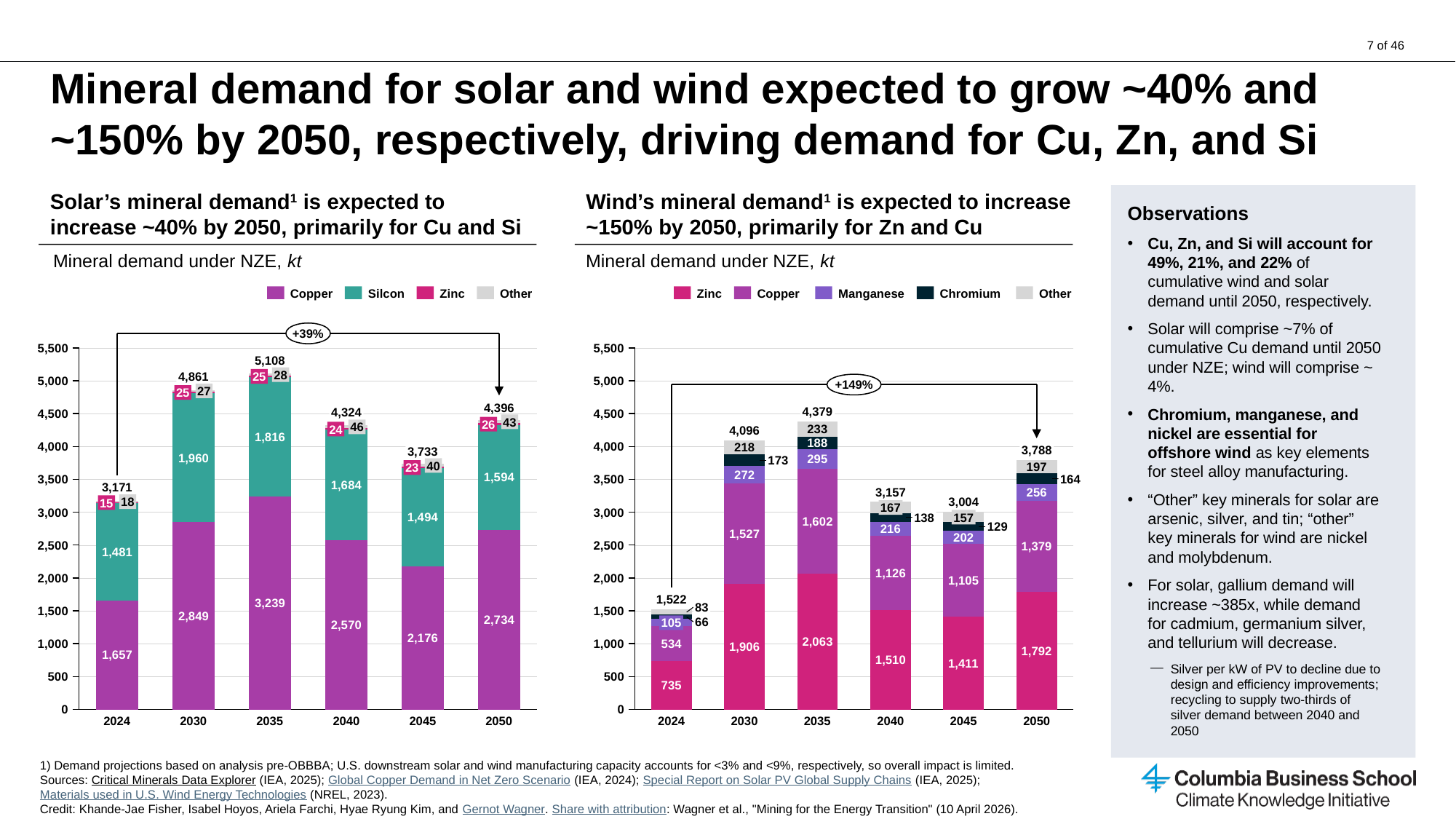
What type of chart is used to show wind's mineral demand (right)? Stacked bar chart In the wind mineral demand chart (right), is the copper demand larger in 2030 or in 2045? 2030 In the wind mineral demand chart (right), how many years are shown on the x axis? 6 In the wind mineral demand chart (right), what is the zinc demand in 2050? 1,792 In the wind mineral demand chart (right), which year has the lowest total mineral demand? 2024 In the solar mineral demand chart (left), which year has the highest total mineral demand? 2035 In the solar mineral demand chart (left), what is the difference between the silicon demand in 2030 and in 2024? 479 In the wind mineral demand chart (right), what is the manganese demand in 2035? 295 In the solar mineral demand chart (left), how many series does the legend list? 4 In the solar mineral demand chart (left), what is the copper demand in 2035? 3,239 In the solar mineral demand chart (left), what is the total mineral demand in 2050? 4,396 In the wind mineral demand chart (right), what percentage increase is annotated between 2024 and 2050? +149%